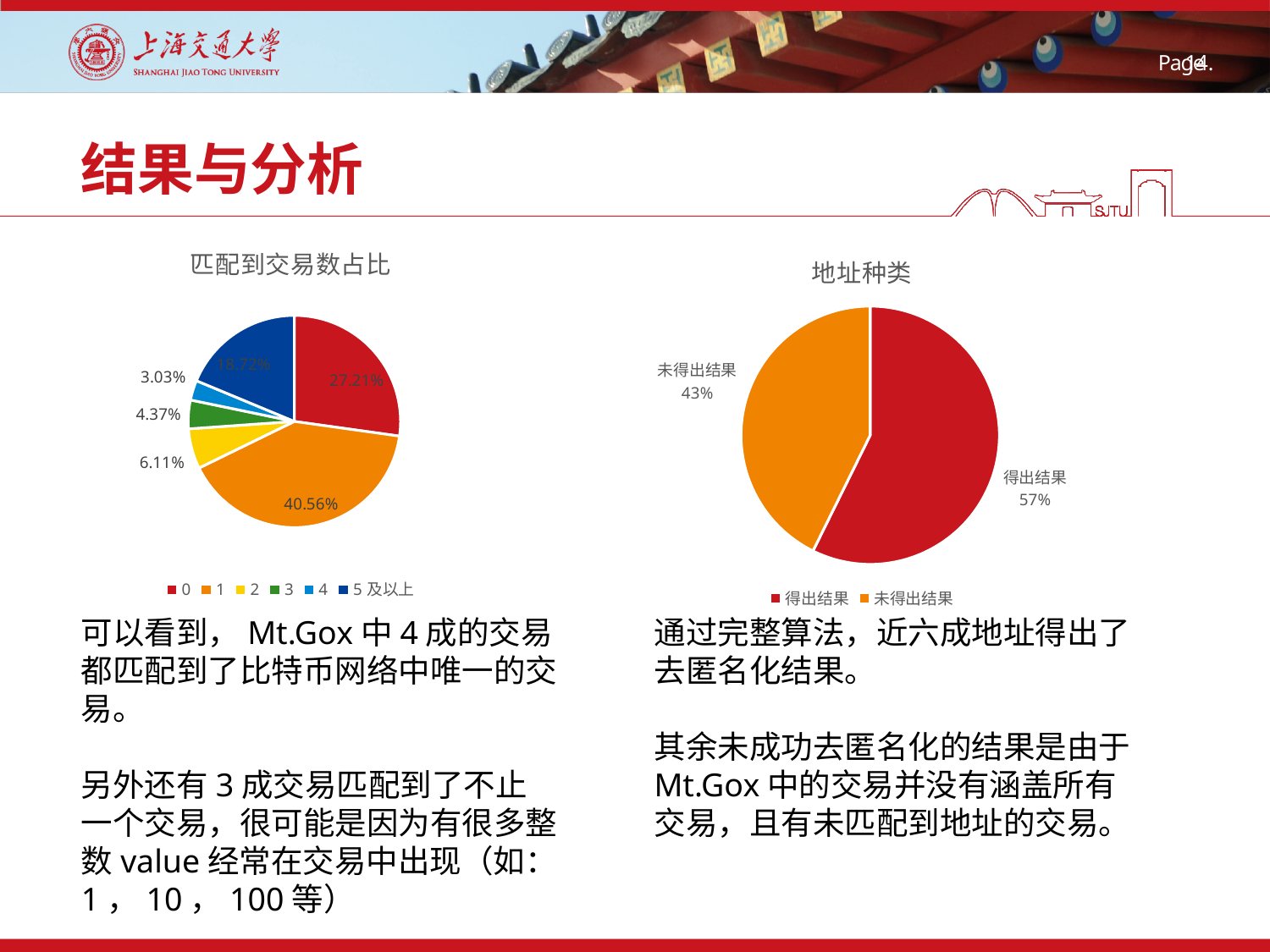
In the chart titled 地址种类, which is larger, 得出结果 or 未得出结果? 得出结果 In the chart titled 匹配到交易数占比, which category has the largest slice? 1 In the chart titled 地址种类, what share does 得出结果 have? 57% In the chart titled 匹配到交易数占比, how many categories does the legend list? 6 In the chart titled 地址种类, what share does 未得出结果 have? 43% In the chart titled 匹配到交易数占比, what share does the slice for category 1 have? 40.56% In the chart titled 匹配到交易数占比, what share does the slice for category 2 have? 6.11% In the chart titled 匹配到交易数占比, what is the difference between the shares for category 1 and category 0? 13.35% In the chart titled 地址种类, what is the difference between the shares of 得出结果 and 未得出结果? 14% In the chart titled 匹配到交易数占比, what share does the slice for category 0 have? 27.21% What type of chart is the chart titled 地址种类? Pie chart In the chart titled 匹配到交易数占比, which category has the smallest slice? 4